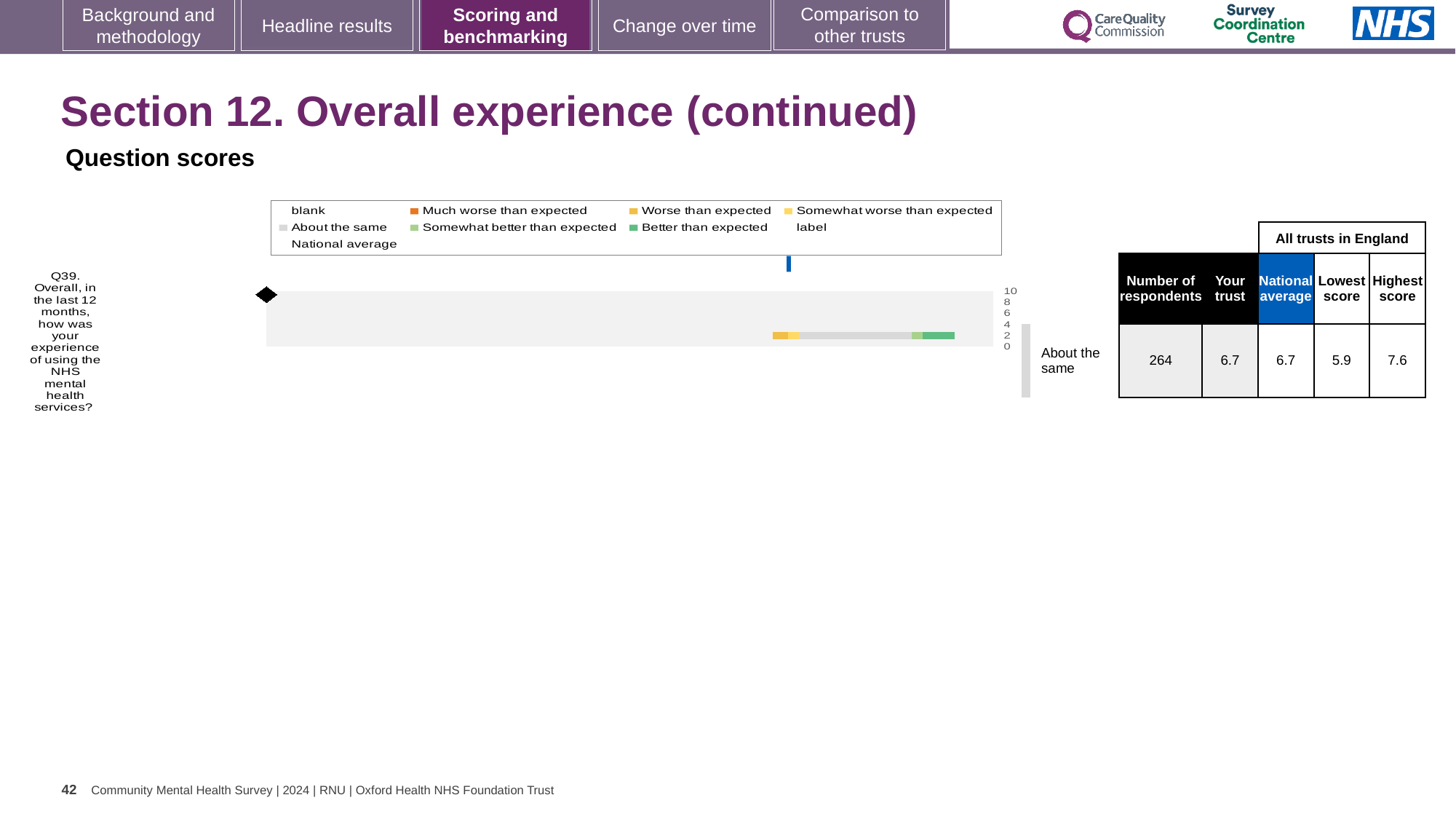
In the table beside the chart, what is the 'Your trust' score for Q39? 6.7 Is the 'Your trust' score for Q39 larger than, smaller than, or equal to the national average? equal In the table beside the chart, what is the highest score among all trusts in England for Q39? 7.6 How many questions (categories) are plotted in the chart? 1 What benchmark label is shown to the right of the chart for Q39? About the same What is the maximum value shown on the chart's numeric axis? 10 What kind of chart is shown on the slide for Q39? bar chart What is the difference between the highest score and the lowest score for Q39 in the table beside the chart? 1.7 In the table beside the chart, what is the national average score for Q39? 6.7 In the table beside the chart, what is the number of respondents for Q39? 264 In the table beside the chart, what is the lowest score among all trusts in England for Q39? 5.9 Which question is plotted in the chart? Q39. Overall, in the last 12 months, how was your experience of using the NHS mental health services?